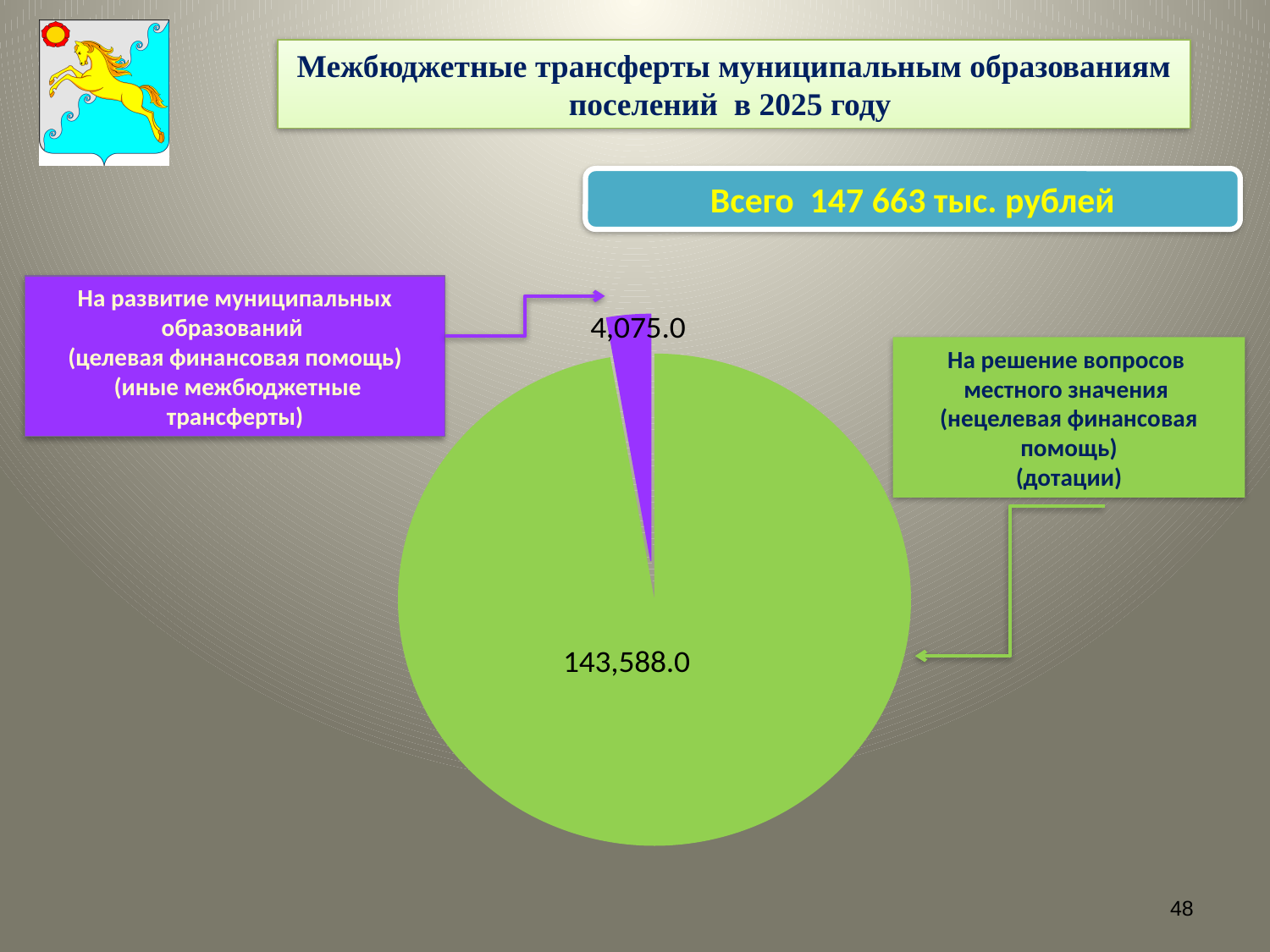
Which is larger: the slice for дотации or the slice for иные межбюджетные трансферты? дотации How many slices does the pie chart have? 2 What type of chart is shown on the slide? pie chart Which slice of the pie chart is the smallest? На развитие муниципальных образований (целевая финансовая помощь) (иные межбюджетные трансферты) What share of the pie does the slice for дотации (143,588.0 out of 147,663.0) represent, to one decimal place? 97.2% What total amount of intergovernmental transfers is stated on the slide? 147 663 тыс. рублей What is the difference between the value for дотации (143,588.0) and the value for иные межбюджетные трансферты (4,075.0)? 139,513.0 Which slice of the pie chart is the largest? На решение вопросов местного значения (нецелевая финансовая помощь) (дотации) What is the value of the slice for 'На решение вопросов местного значения (нецелевая финансовая помощь) (дотации)'? 143,588.0 What is the value of the slice for 'На развитие муниципальных образований (целевая финансовая помощь) (иные межбюджетные трансферты)'? 4,075.0 What is the total of the two slices in the pie chart? 147,663.0 What colour is the slice for 'На решение вопросов местного значения (дотации)'? green